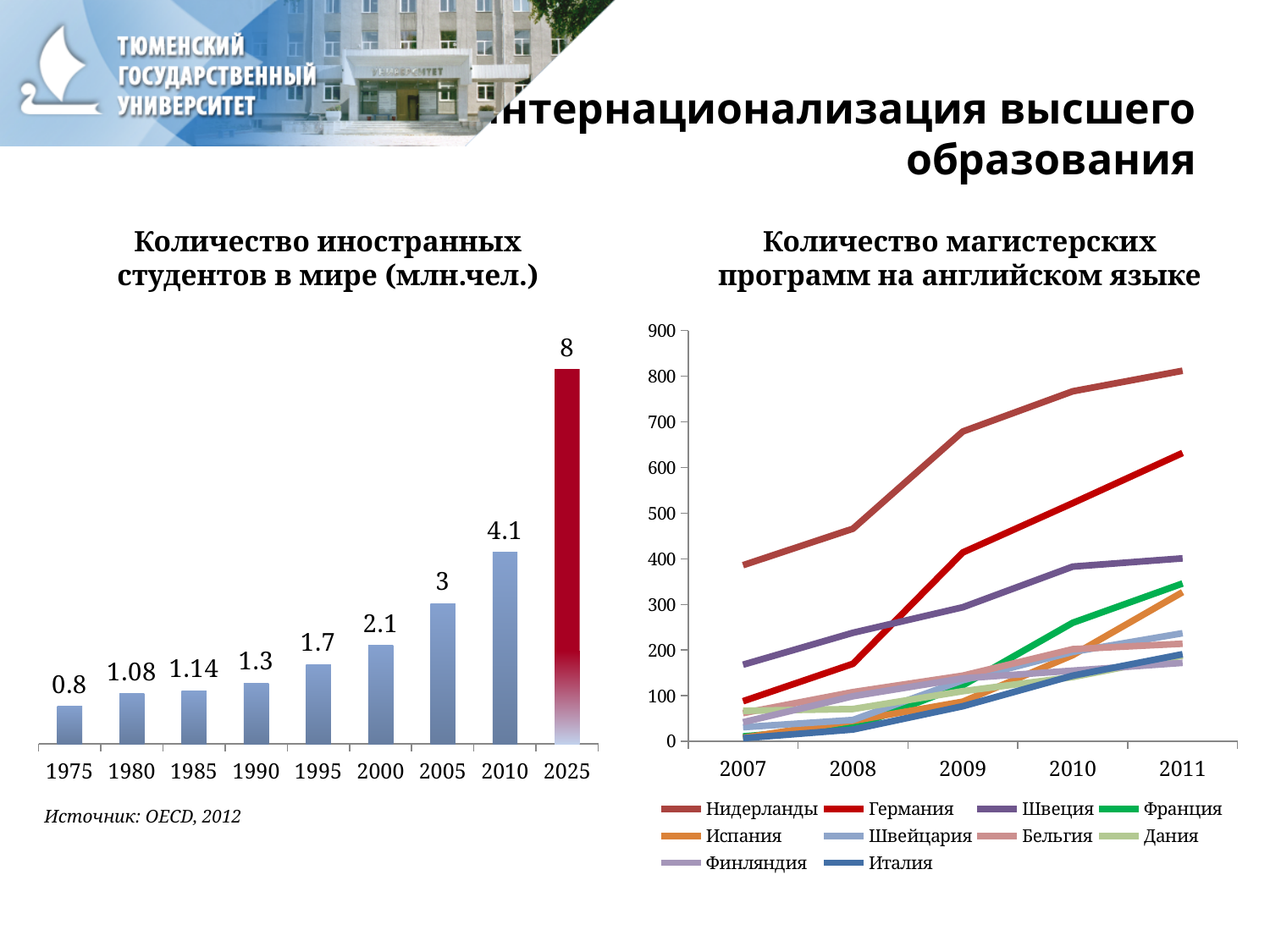
In the chart 'Количество магистерских программ на английском языке', which is larger in 2009: Нидерланды or Швеция? Нидерланды In the chart 'Количество иностранных студентов в мире (млн.чел.)', how many years are shown on the x axis? 9 In the chart 'Количество иностранных студентов в мире (млн.чел.)', what is the difference between the values for 2025 and 2010? 3.9 In the chart 'Количество иностранных студентов в мире (млн.чел.)', what is the value for 2010? 4.1 In the chart 'Количество иностранных студентов в мире (млн.чел.)', which year has the highest value? 2025 In the chart 'Количество иностранных студентов в мире (млн.чел.)', do the values rise or fall from 1975 to 2025? rise In the chart 'Количество магистерских программ на английском языке', is the value for Германия in 2011 greater or less than 600? greater What kind of chart is 'Количество иностранных студентов в мире (млн.чел.)'? bar chart In the chart 'Количество магистерских программ на английском языке', how many series does the legend list? 10 In the chart 'Количество магистерских программ на английском языке', which country has the highest value in 2011? Нидерланды In the chart 'Количество иностранных студентов в мире (млн.чел.)', what is the value for 1980? 1.08 In the chart 'Количество иностранных студентов в мире (млн.чел.)', which year has the lowest value? 1975